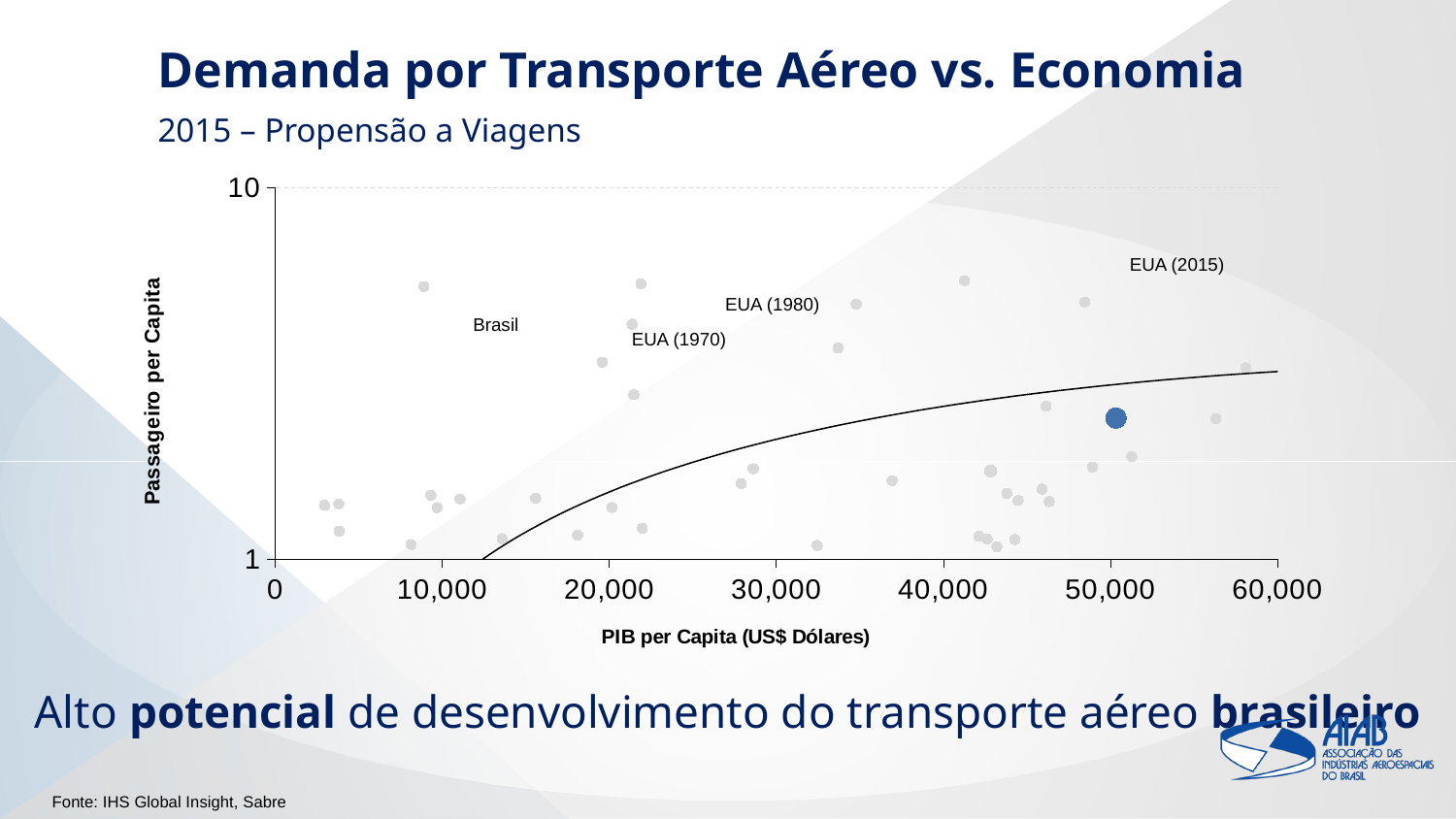
What is the highest tick value shown on the x axis? 60,000 Is the PIB per Capita value of the highlighted blue point greater or less than 60,000? less What is the label of the x axis of the chart? PIB per Capita (US$ Dólares) What is the lowest tick value shown on the y axis? 1 What is the title of the chart on the slide? Demanda por Transporte Aéreo vs. Economia What is the label of the y axis of the chart? Passageiro per Capita Is the PIB per Capita value of the highlighted blue point greater or less than 40,000? greater What kind of chart is shown on the slide? Scatter chart What is the highest tick value shown on the y axis? 10 How many points on the chart have a text label naming a country? 4 Does the fitted curve rise or fall as PIB per Capita increases along the x axis? rises What year does the subtitle of the chart refer to? 2015